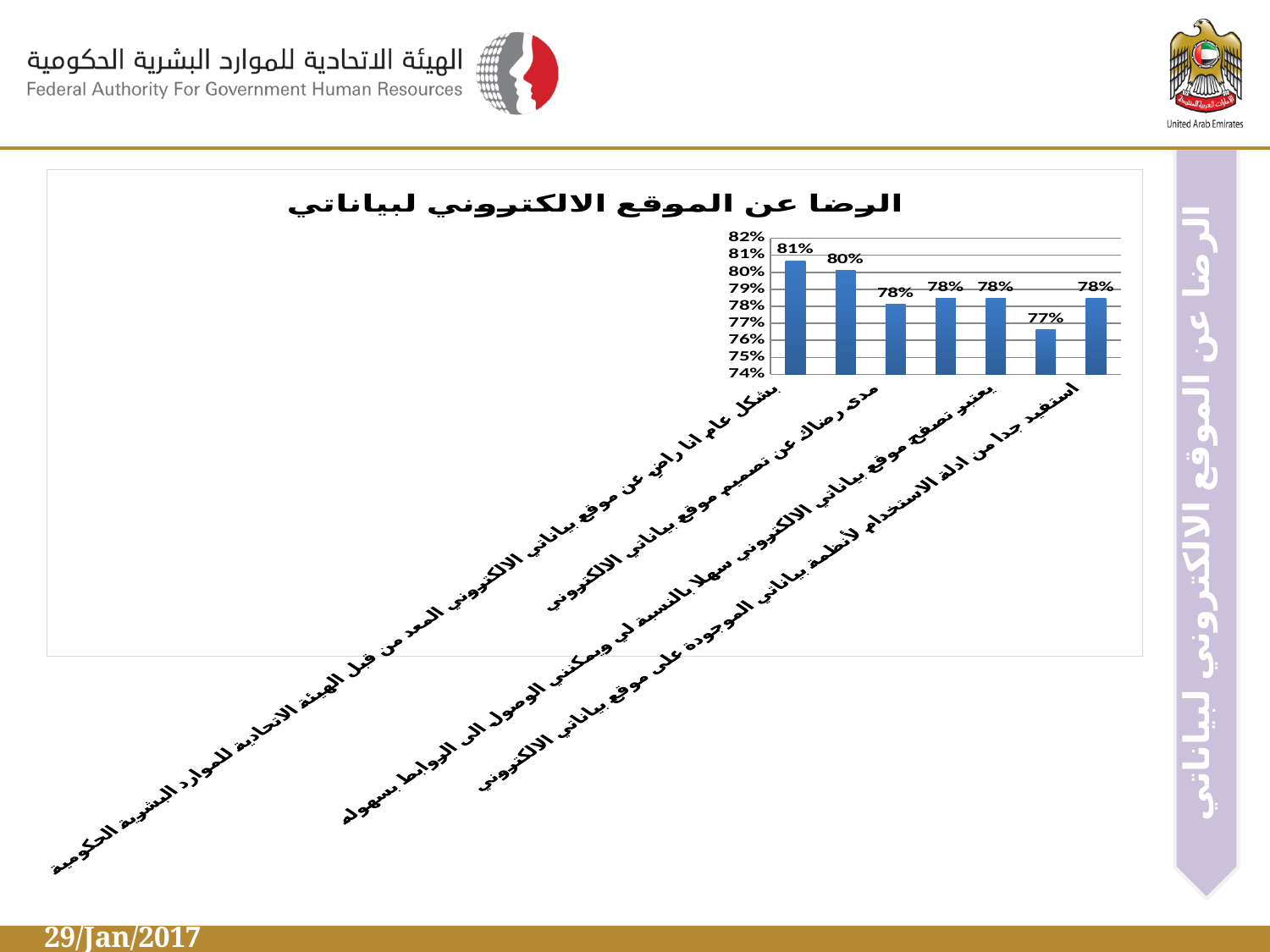
What type of chart is shown on the slide? Bar chart What colour are the bars in the chart? Blue What is the highest value shown in the chart? 81% Which is larger, the second bar from the left or the third bar from the left? The second bar (80%) What is the difference between the highest and lowest values in the chart? 4 percentage points What is the value of the first (leftmost) bar in the chart? 81% What is the lowest value shown in the chart? 77% How many bars in the chart have a value of 78%? 4 What is the title of the chart? الرضا عن الموقع الالكتروني لبياناتي How many bars are plotted in the chart? 7 What is the value of the sixth bar from the left in the chart? 77% What is the value of the second bar from the left in the chart? 80%